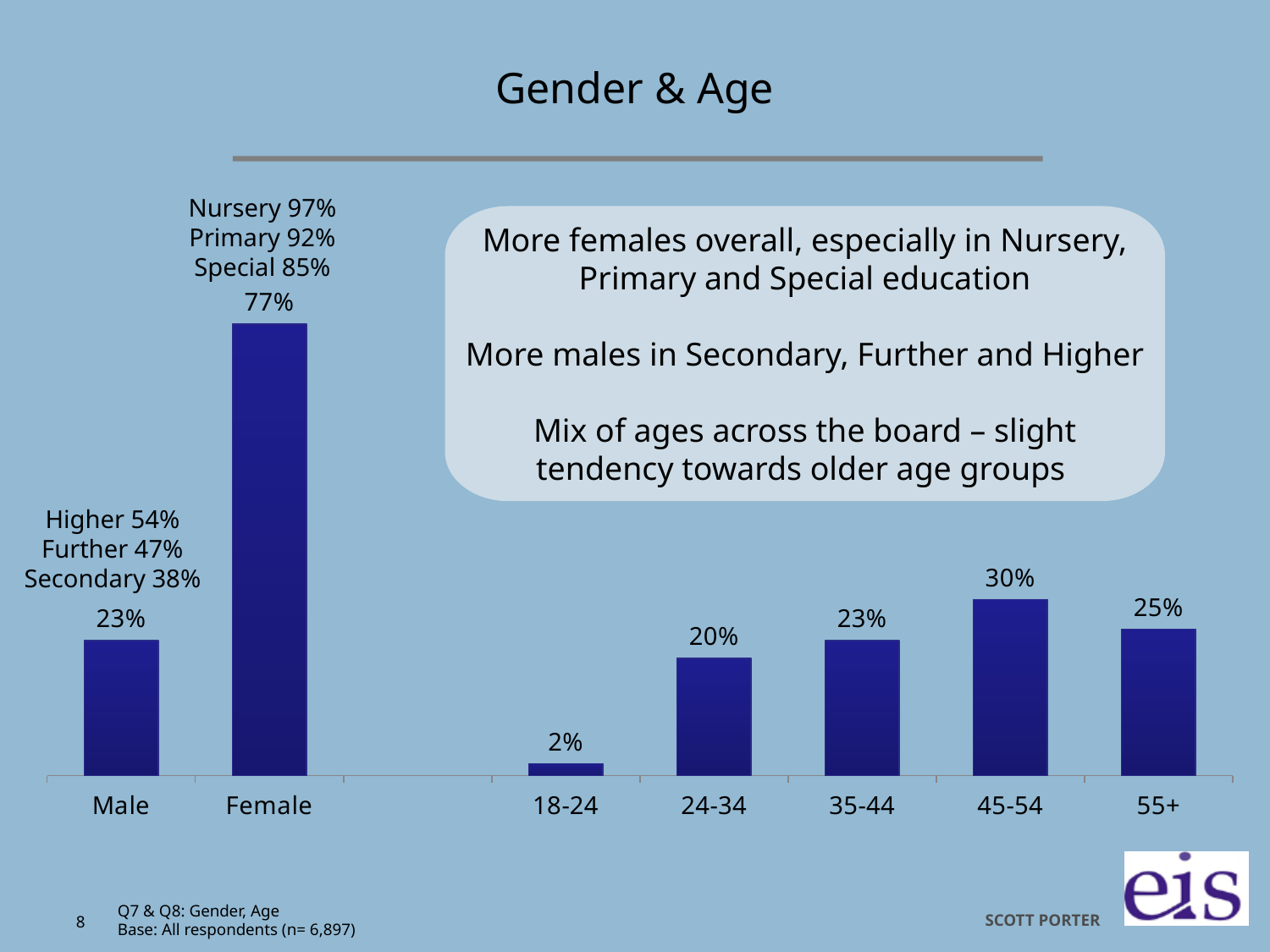
Which age group has the lowest value? 18-24 What is the value for Male? 23% What is the value for Female? 77% What kind of chart is shown on the slide? bar chart What is the difference between the 45-54 and 24-34 values? 10% What is the value for the 45-54 age group? 30% Which age group has the highest value? 45-54 What is the title of the slide? Gender & Age How many age group categories are shown on the chart? 5 What is the difference between the Female and Male values? 54% Which is larger, the value for 55+ or the value for 35-44? 55+ What is the value for the 18-24 age group? 2%